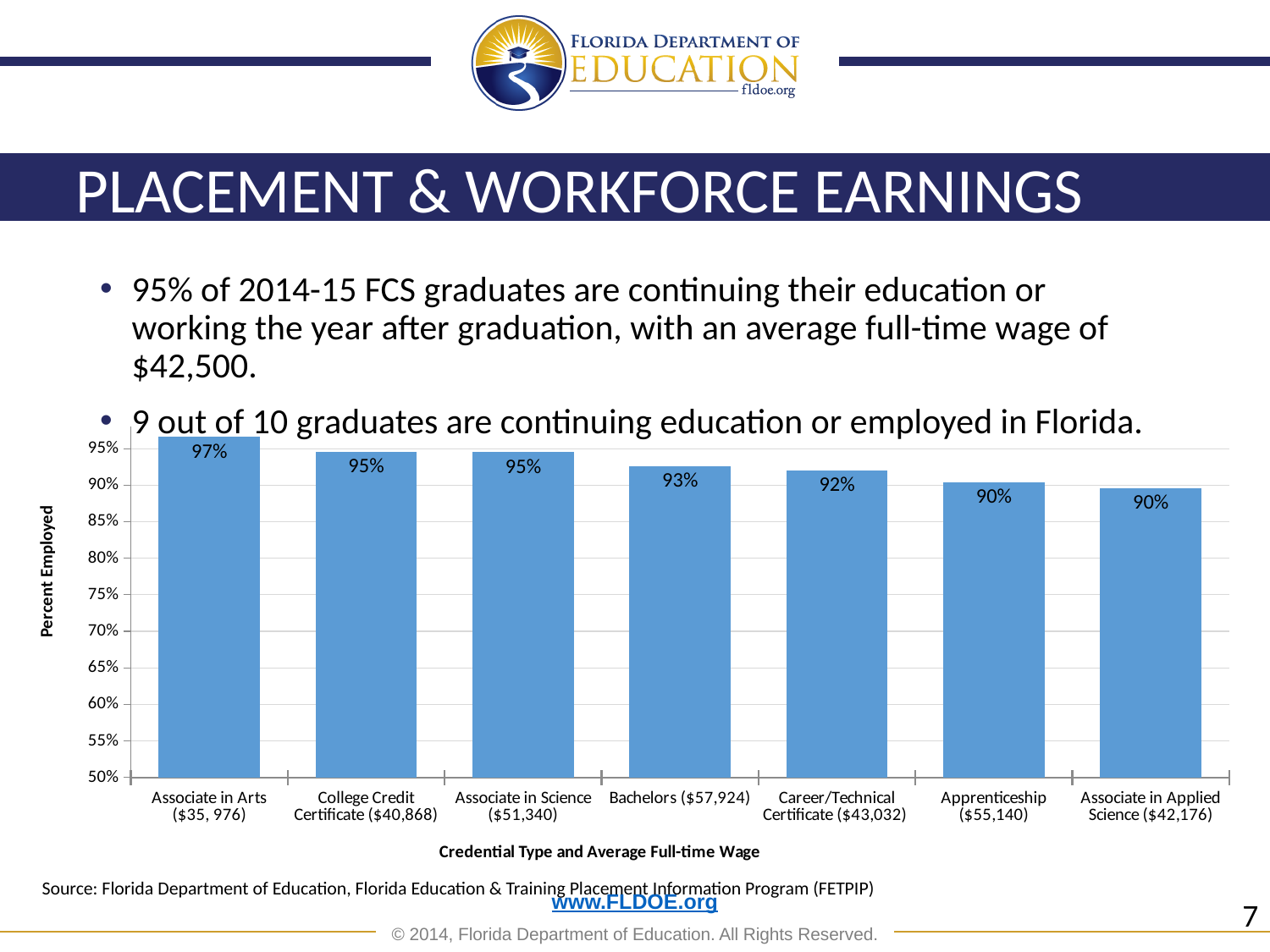
What is the difference in percent employed between Associate in Arts ($35, 976) and Bachelors ($57,924)? 4 percentage points What is the percent employed for Apprenticeship ($55,140)? 90% What is the percent employed for Associate in Arts ($35, 976)? 97% How many credential types are shown in the chart? 7 Which credential type has the highest percent employed? Associate in Arts ($35, 976) Is the value for Career/Technical Certificate ($43,032) greater or less than 90%? greater What kind of chart is shown on the slide? bar chart Which has a higher percent employed: College Credit Certificate ($40,868) or Associate in Applied Science ($42,176)? College Credit Certificate ($40,868) What is the label of the chart's x axis? Credential Type and Average Full-time Wage What is the percent employed for Career/Technical Certificate ($43,032)? 92% Do the percent employed values rise or fall from left to right across the chart? fall What is the percent employed for Bachelors ($57,924)? 93%